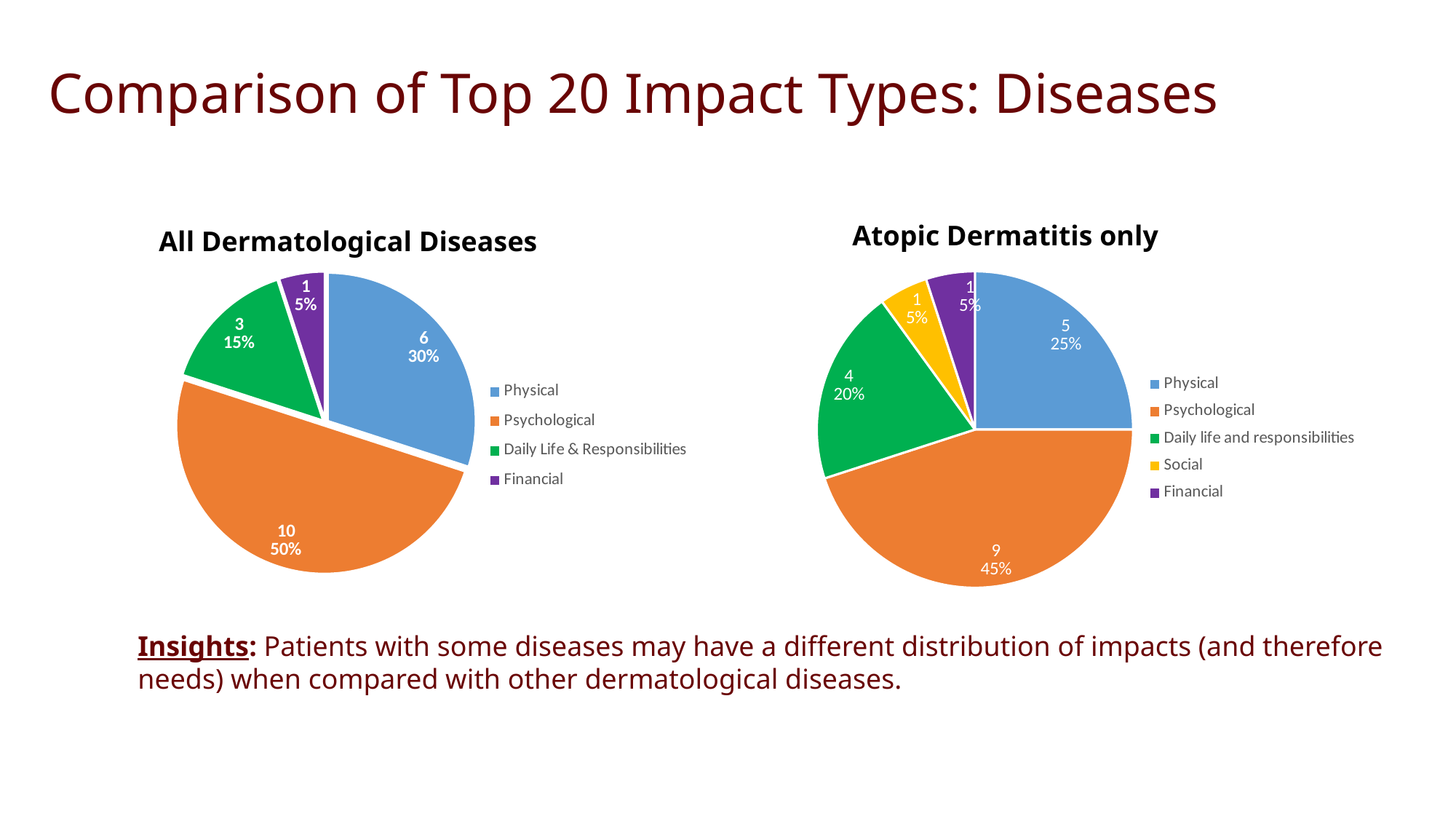
Which is larger: the Physical share in the 'All Dermatological Diseases' chart or the Physical share in the 'Atopic Dermatitis only' chart? All Dermatological Diseases In the 'Atopic Dermatitis only' chart, which category has the largest slice? Psychological In the 'Atopic Dermatitis only' chart, what share of the pie does Daily life and responsibilities take? 20% In the 'Atopic Dermatitis only' chart, what is the difference between the counts for Psychological and Physical? 4 In the 'All Dermatological Diseases' chart, which category has the smallest slice? Financial In the 'Atopic Dermatitis only' chart, how many categories does the legend list? 5 What kind of chart is the 'All Dermatological Diseases' chart? Pie chart In the 'All Dermatological Diseases' chart, what is the count shown for Physical? 6 In the 'Atopic Dermatitis only' chart, what is the count shown for Psychological? 9 In the 'All Dermatological Diseases' chart, what share of the pie does Psychological take? 50% In the 'All Dermatological Diseases' chart, how many categories does the legend list? 4 In the 'Atopic Dermatitis only' chart, which category is shown in yellow? Social